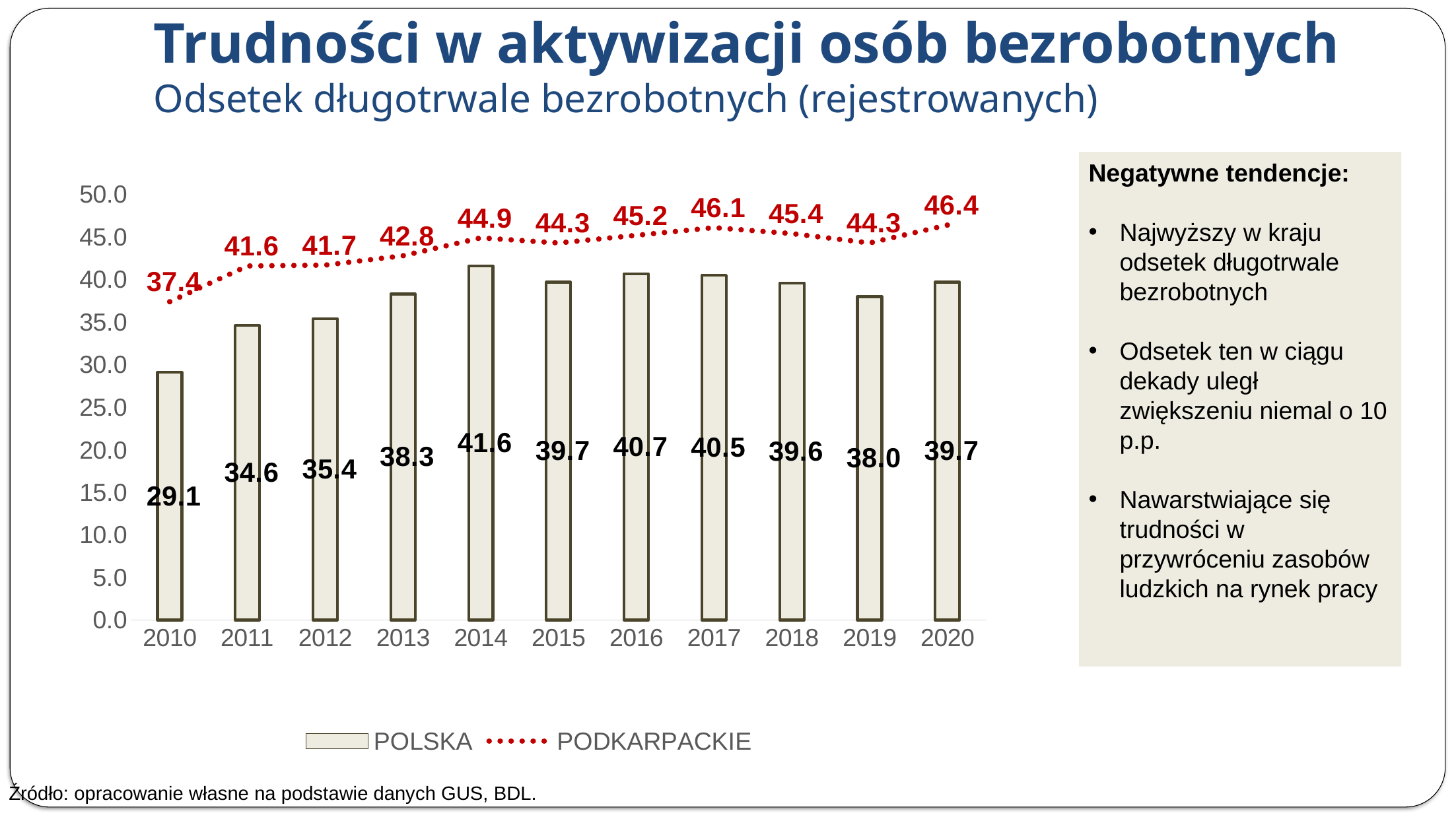
How many series does the legend list? 2 In which year is the POLSKA value lowest? 2010 In which year is the POLSKA value highest? 2014 What is the difference between the PODKARPACKIE and POLSKA values in 2020? 6.7 How many years are shown on the x axis? 11 Which series is shown as a red dotted line? PODKARPACKIE In which year is the PODKARPACKIE value highest? 2020 What is the value for POLSKA in 2014? 41.6 What kind of chart is used for the POLSKA series? bar chart What is the value for PODKARPACKIE in 2010? 37.4 Which is larger in 2019, the POLSKA value or the PODKARPACKIE value? PODKARPACKIE What is the value for PODKARPACKIE in 2017? 46.1